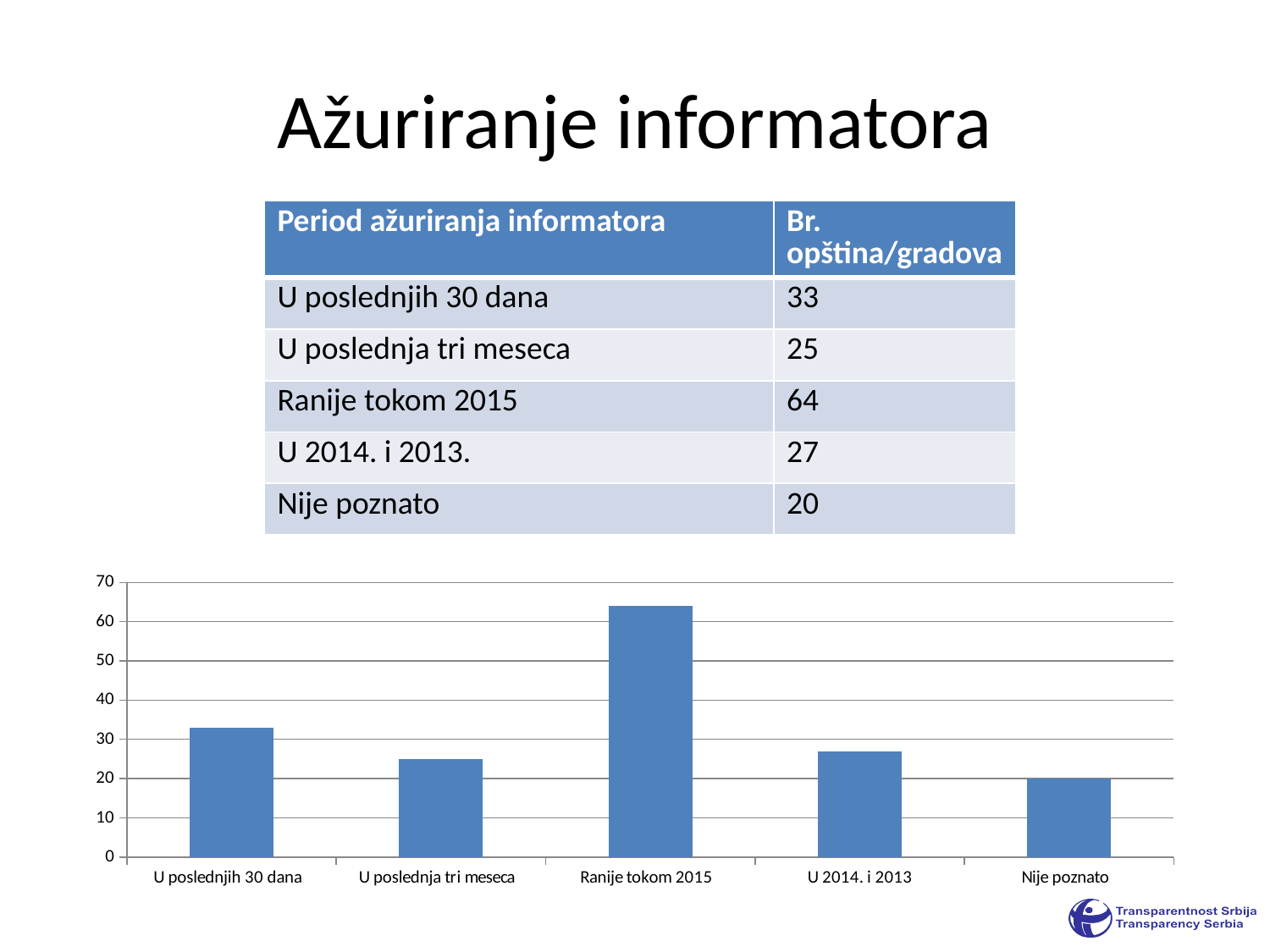
What is the value for 'Ranije tokom 2015'? 64 Which category has the highest bar in the chart? Ranije tokom 2015 Which category has the lowest bar in the chart? Nije poznato What is the value for 'Nije poznato'? 20 What is the difference between the values for 'Ranije tokom 2015' and 'U poslednja tri meseca'? 39 What is the title of the slide containing the chart? Ažuriranje informatora Which is larger, the value for 'U poslednjih 30 dana' or the value for 'U 2014. i 2013'? U poslednjih 30 dana Is the value for 'U poslednja tri meseca' greater or less than 30? less Is the value for 'Ranije tokom 2015' greater or less than 60? greater What is the value for 'U poslednjih 30 dana'? 33 How many categories does the bar chart show? 5 What kind of chart is shown on the slide? bar chart